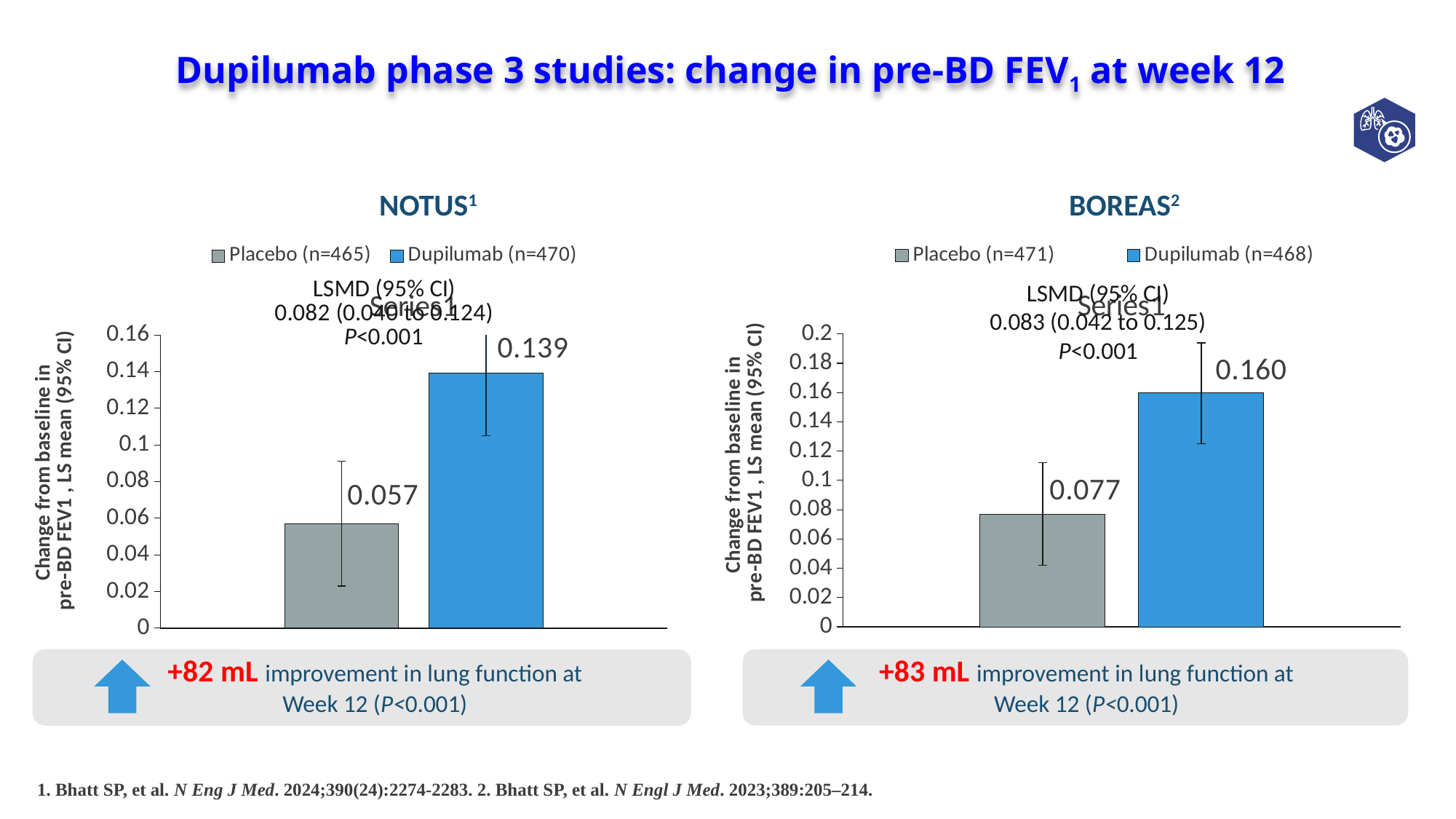
In the NOTUS chart, what is the value for Dupilumab (n=470)? 0.139 What kind of chart is the BOREAS chart? bar chart In the BOREAS chart, what is the difference between the Dupilumab and Placebo values? 0.083 In the NOTUS chart, what colour is the Dupilumab bar? blue In the BOREAS chart, what is the value for Placebo (n=471)? 0.077 In the BOREAS chart, what is the value for Dupilumab (n=468)? 0.160 In the BOREAS chart, which series has the lower value? Placebo (n=471) In the BOREAS chart, is the value for Placebo (n=471) greater or less than 0.1? less How many series does the legend of the NOTUS chart list? 2 In the NOTUS chart, what is the difference between the Dupilumab and Placebo values? 0.082 In the NOTUS chart, which series has the higher value? Dupilumab (n=470) In the NOTUS chart, what is the value for Placebo (n=465)? 0.057